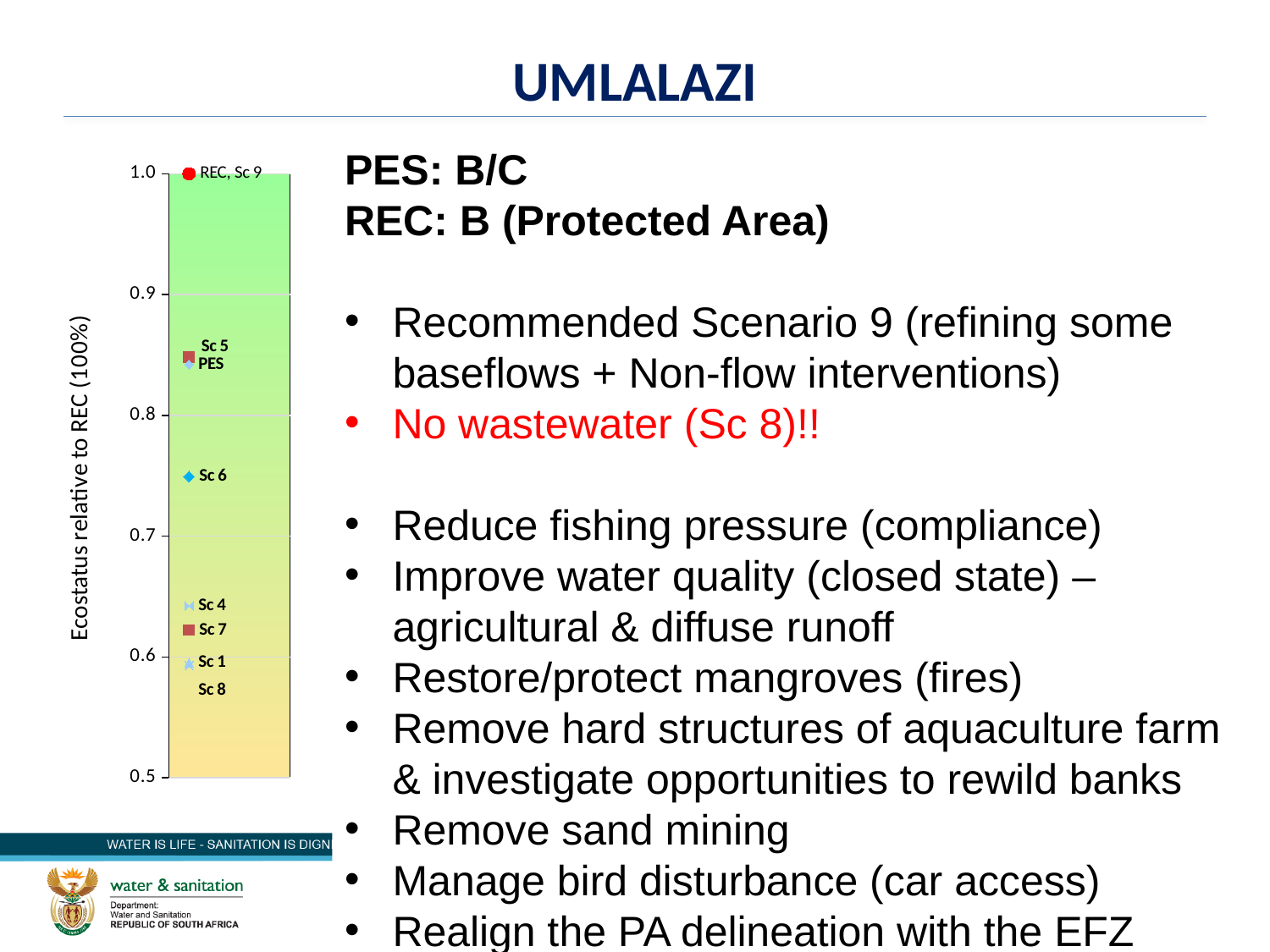
Is the value for Sc 5 greater or less than 0.8? greater Is the value for PES greater or less than 0.9? less Which has the higher value, Sc 6 or Sc 4? Sc 6 Is the value for Sc 7 greater or less than 0.7? less Which labelled point sits lowest on the chart? Sc 8 Which has the higher value, Sc 5 or Sc 6? Sc 5 What is the y-axis label of the chart? Ecostatus relative to REC (100%) What value does the REC, Sc 9 marker sit at on the y-axis? 1.0 Which labelled point sits highest on the chart? REC, Sc 9 What are the lowest and highest values shown on the y-axis? 0.5 and 1.0